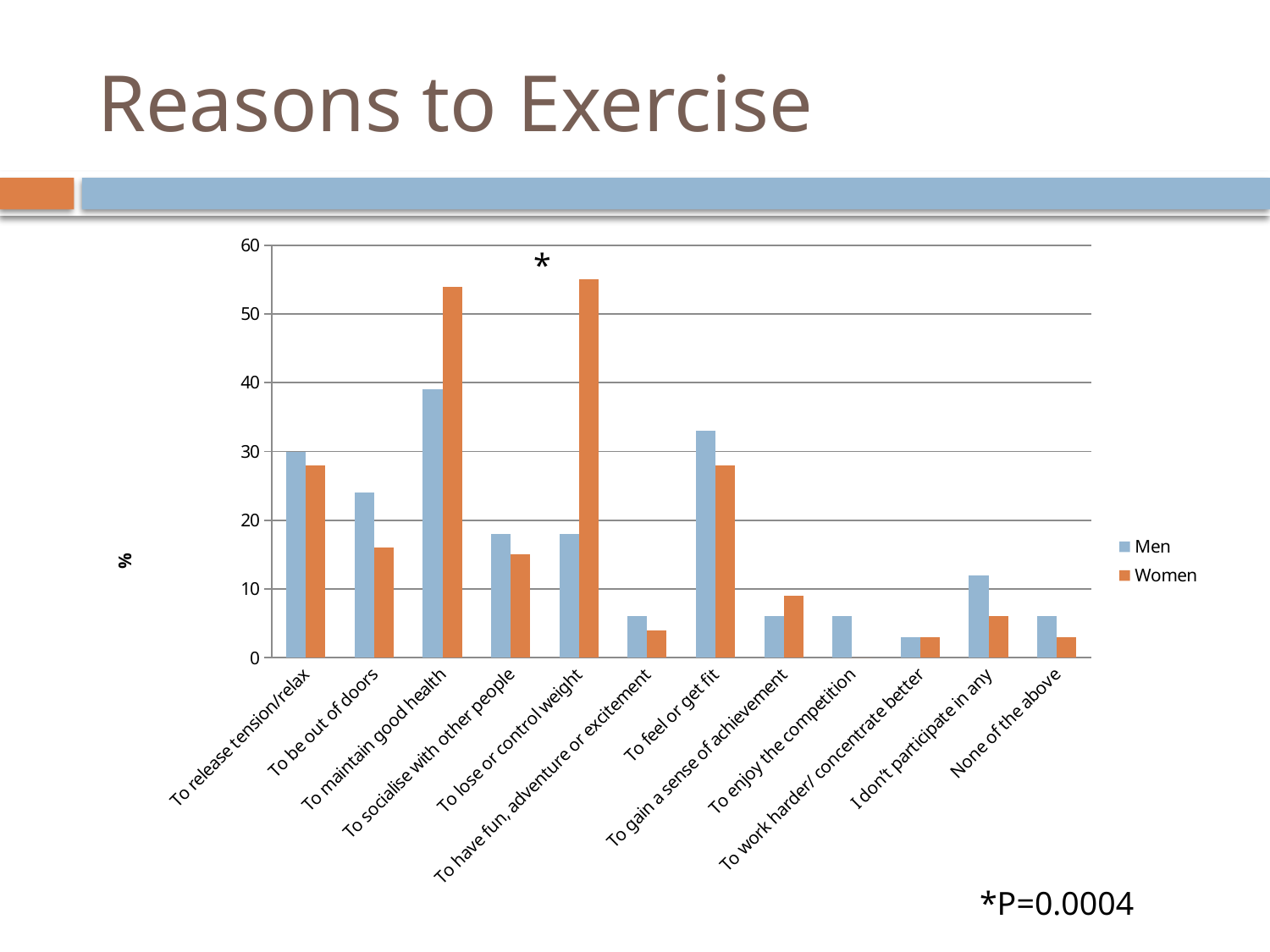
How many reason categories are shown on the x axis? 12 For 'To be out of doors', which is larger, the value for Men or for Women? Men Which category has the highest value for Men? To maintain good health For 'To lose or control weight', which is larger, the value for Men or for Women? Women What label is shown on the y axis? % Is the value for Men for 'To be out of doors' greater or less than 20? greater Which category has the highest value for Women? To lose or control weight How many series does the legend list? 2 Is the value for Women for 'To maintain good health' greater or less than 50? greater Is the value for Women for 'To be out of doors' greater or less than 20? less Which category has the lowest value for Men? To work harder/ concentrate better What kind of chart is shown on the slide? bar chart